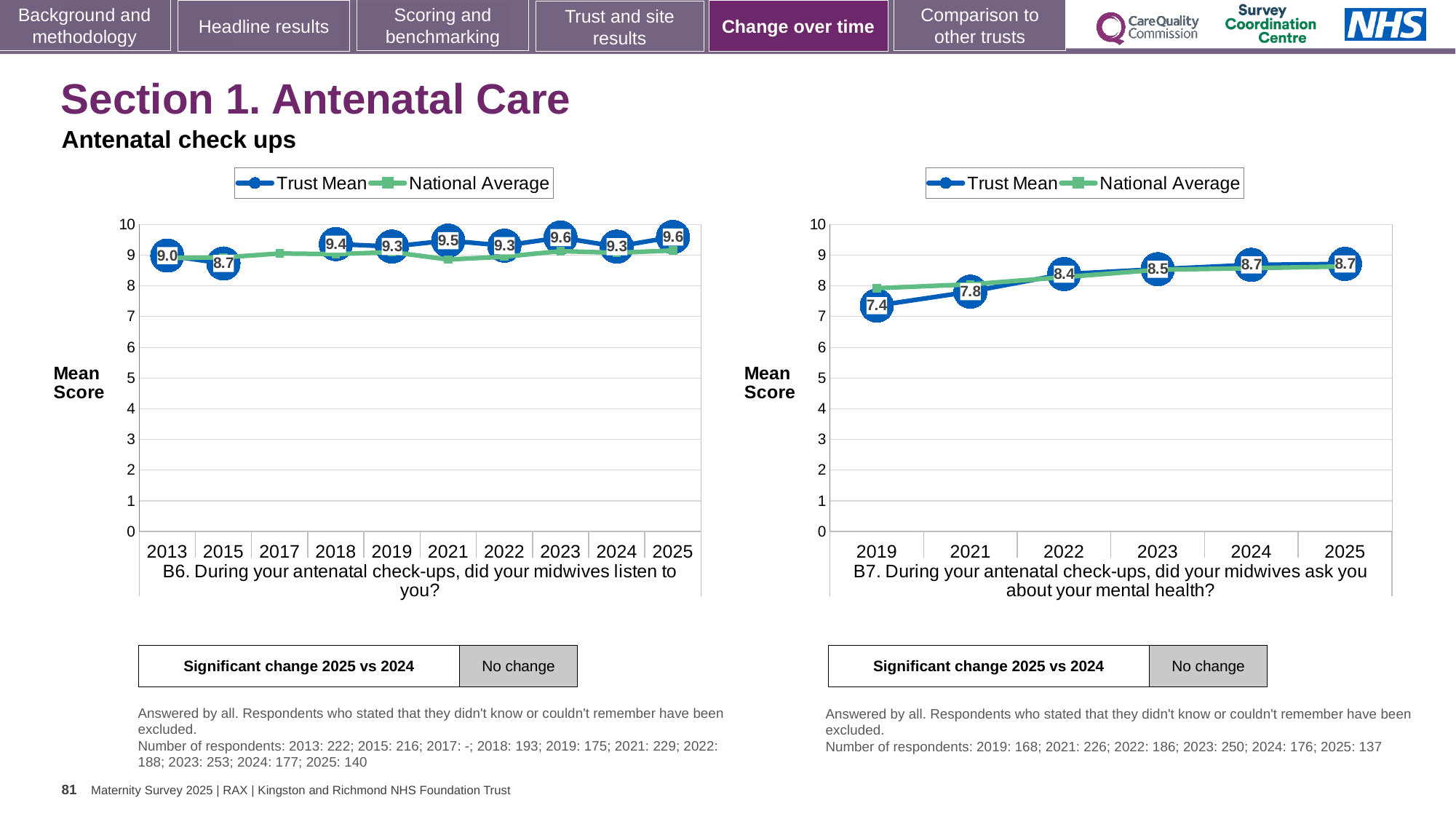
What kind of chart is the B7 chart (right)? Line chart In the B6 chart (left), which year has the lowest Trust Mean? 2015 In the B7 chart (right), what is the Trust Mean for 2019? 7.4 How many series does the legend of the B6 chart (left) list? 2 In the B7 chart (right), what is the Trust Mean for 2022? 8.4 In the B6 chart (left), which is larger, the Trust Mean for 2021 or for 2024? 2021 In the B6 chart (left), what is the Trust Mean for 2025? 9.6 How many years are shown on the x axis of the B7 chart (right)? 6 In the B7 chart (right), is the National Average for 2019 greater or less than 7? greater In the B7 chart (right), which year has the lowest Trust Mean? 2019 In the B6 chart (left), what is the Trust Mean for 2015? 8.7 In the B7 chart (right), what is the difference between the Trust Mean for 2025 and for 2019? 1.3